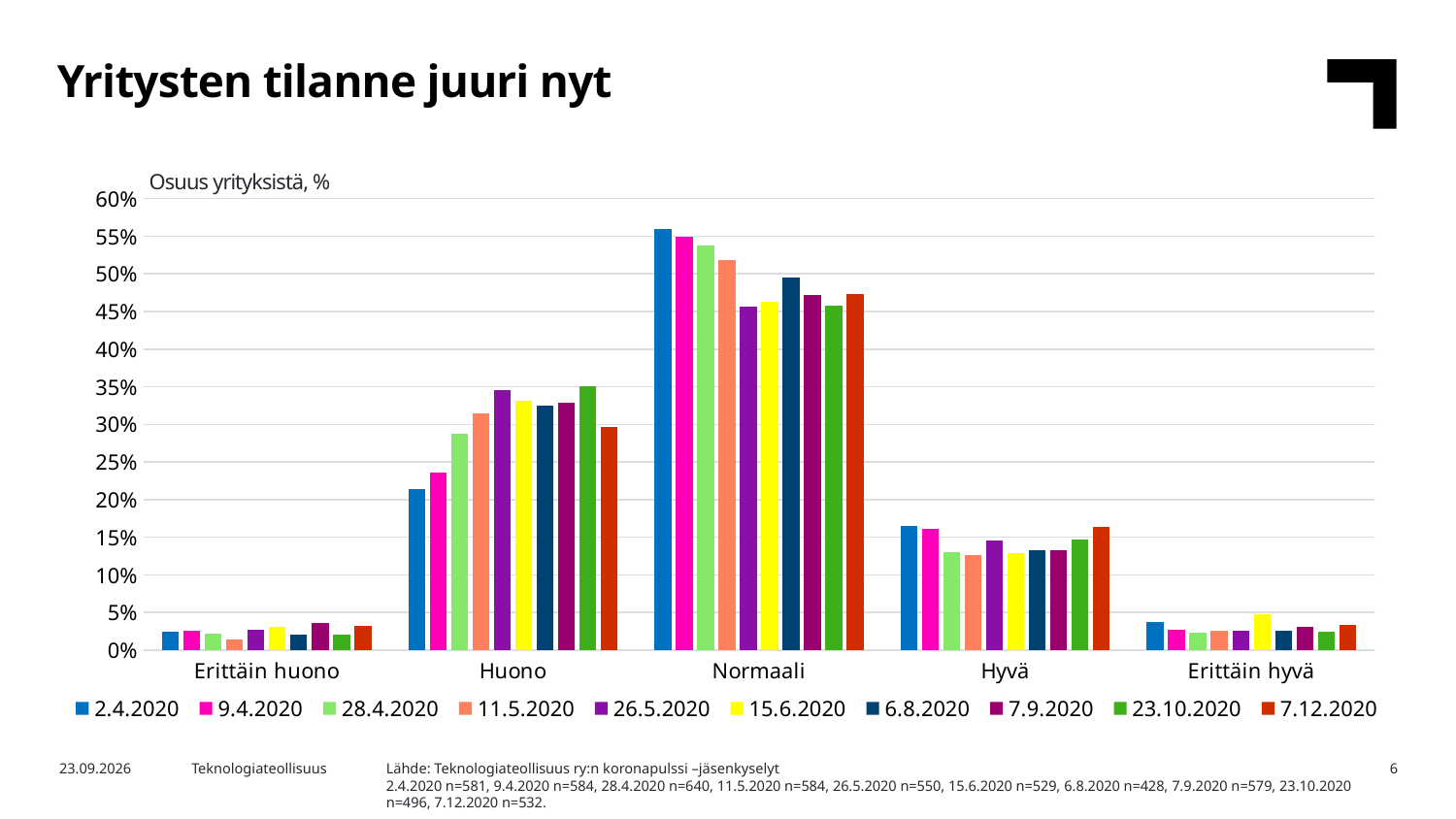
What kind of chart is shown on the slide? bar chart Is the value for Hyvä in the 7.12.2020 series greater or less than 15%? greater Is the value for Huono in the 2.4.2020 series greater or less than 25%? less How many categories are shown on the x axis of the chart? 5 For the Normaali category, which is larger: the 2.4.2020 value or the 7.12.2020 value? 2.4.2020 Is the value for Erittäin huono in the 2.4.2020 series greater or less than 5%? less What is the label shown above the y axis of the chart? Osuus yrityksistä, % For the Huono category, which is larger: the 2.4.2020 value or the 23.10.2020 value? 23.10.2020 For the 2.4.2020 series, which category has the highest bar? Normaali For the Huono category, do the values rise or fall from the 2.4.2020 series to the 26.5.2020 series? rise How many series does the chart legend list? 10